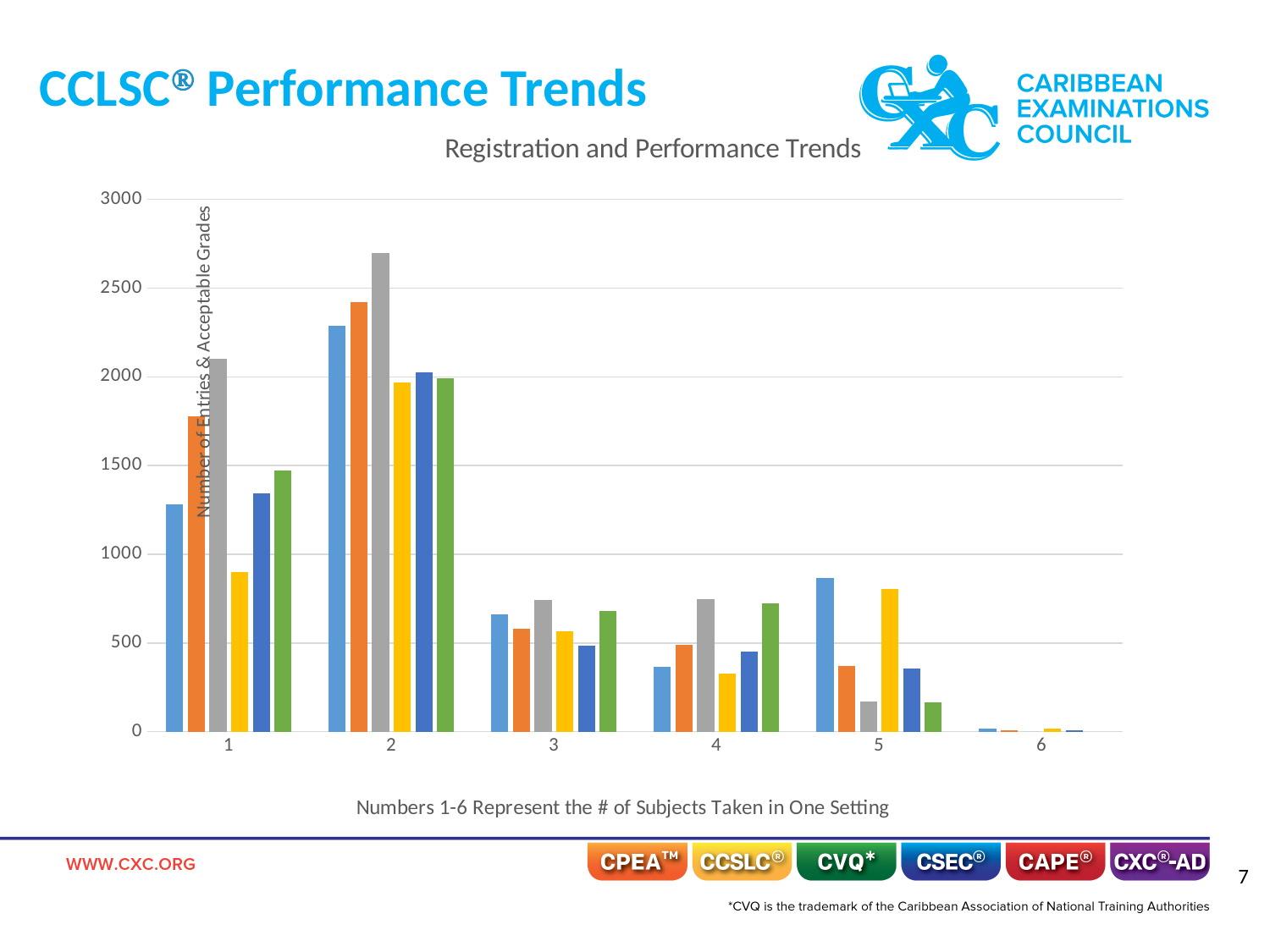
How many bars are plotted for each category on the chart? 6 What is the label on the vertical axis of the chart? Number of Entries & Acceptable Grades Do the light blue bars rise or fall from category 2 to category 4? fall Is the value of the first (light blue) bar for category 1 greater or less than 1500? less Is the value of the orange bar for category 1 greater or less than 1500? greater Is the value of the gray bar for category 2 greater or less than 2500? greater Which is larger: the gray bar for category 1 or the gray bar for category 2? the gray bar for category 2 Which category on the x axis contains the tallest bar in the chart? 2 Which category on the x axis has the lowest bars in the chart? 6 What kind of chart is shown on the slide? bar chart How many categories are shown on the x axis of the chart? 6 What is the title of the chart? Registration and Performance Trends